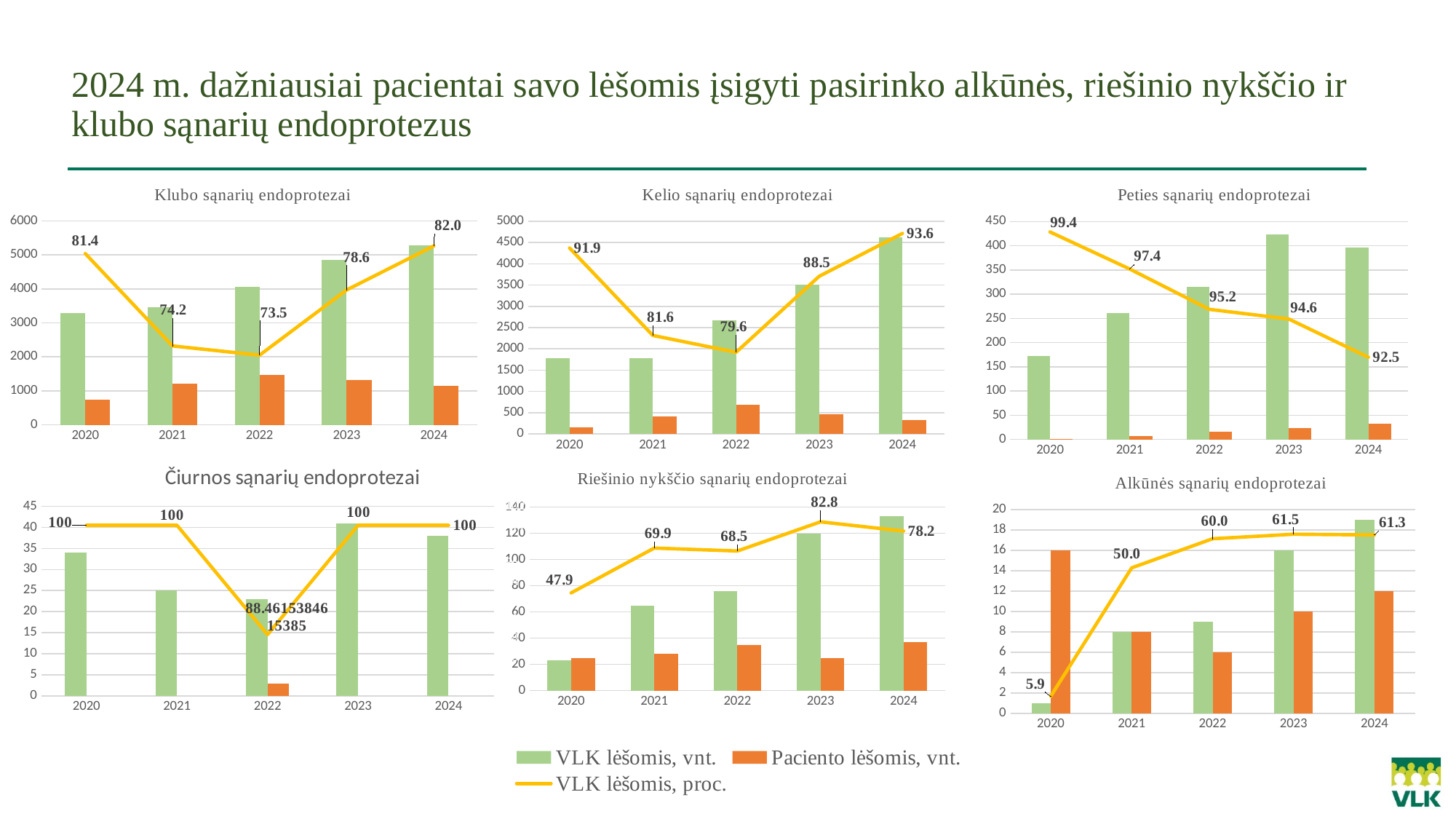
How many years are shown on the x axis of the Kelio sąnarių endoprotezai chart? 5 In the Kelio sąnarių endoprotezai chart, which year has the lowest VLK lėšomis, proc. value? 2022 In the Peties sąnarių endoprotezai chart, what is the VLK lėšomis, proc. value for 2020? 99.4 In the Klubo sąnarių endoprotezai chart, is the VLK lėšomis, vnt. value for 2024 greater or less than 5000? greater In the Kelio sąnarių endoprotezai chart, what is the VLK lėšomis, proc. value for 2024? 93.6 In the Alkūnės sąnarių endoprotezai chart, what is the VLK lėšomis, proc. value for 2020? 5.9 In the Alkūnės sąnarių endoprotezai chart, which year has the larger VLK lėšomis, proc. value, 2022 or 2023? 2023 In the Peties sąnarių endoprotezai chart, does the VLK lėšomis, proc. line rise or fall from 2020 to 2024? fall In the Riešinio nykščio sąnarių endoprotezai chart, what is the difference between the VLK lėšomis, proc. values for 2023 and 2020? 34.9 In the Alkūnės sąnarių endoprotezai chart, is the Paciento lėšomis, vnt. value for 2020 greater or less than 14? greater In the Klubo sąnarių endoprotezai chart, what is the VLK lėšomis, proc. value for 2024? 82.0 How many series does the shared legend at the bottom of the slide list? 3